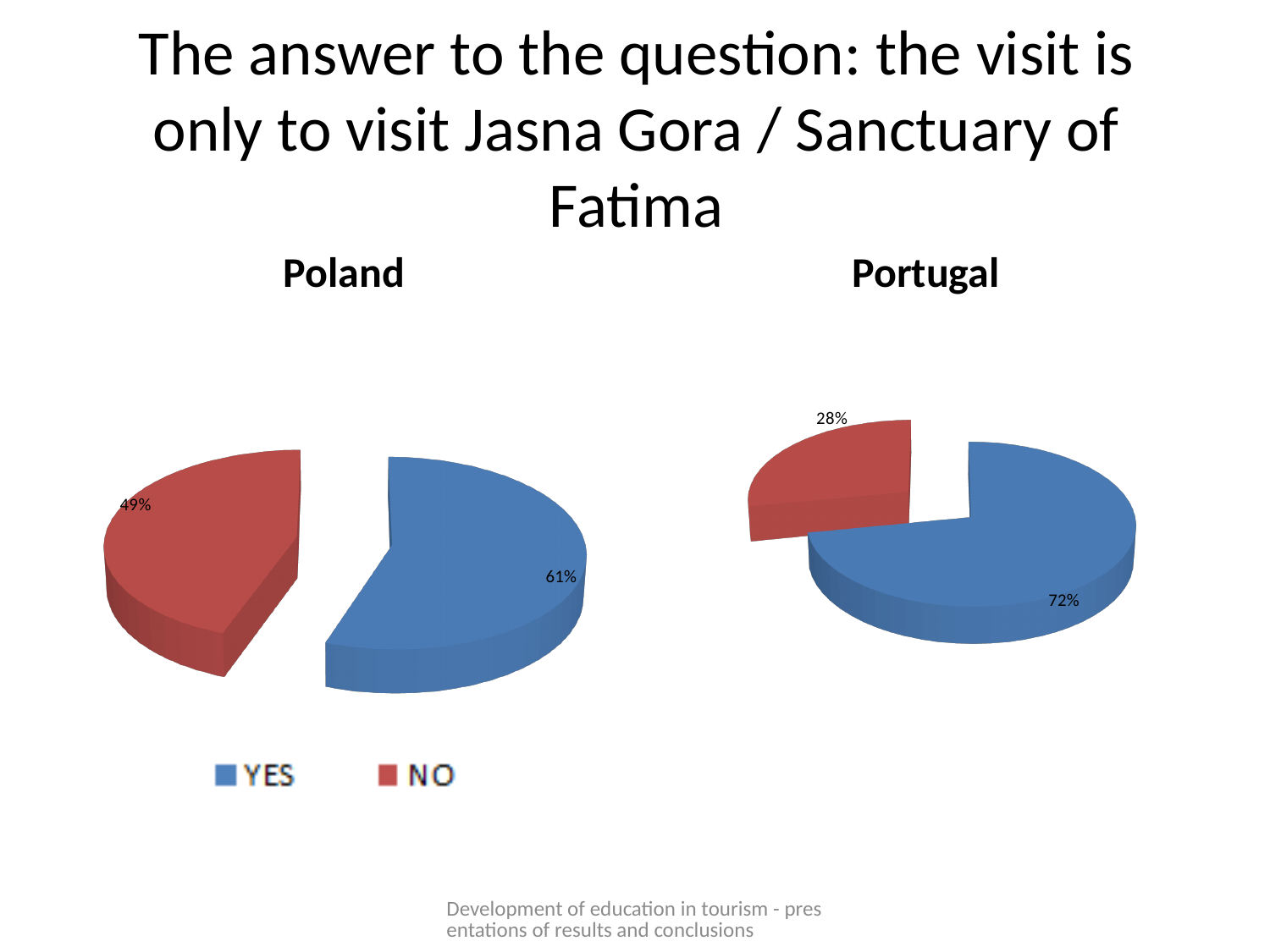
Which colour represents the NO answer in the charts? Red Which country has the higher YES percentage, Poland or Portugal? Portugal In the Poland chart, what percentage answered YES? 61% In the Portugal chart, what is the difference between the YES and NO percentages? 44% What kind of charts are shown on the slide? Pie charts In the Portugal chart, which answer has the largest slice? YES In the Portugal chart, what percentage answered YES? 72% In the Portugal chart, which answer has the smallest slice? NO In the Poland chart, what percentage answered NO? 49% How many entries does the legend list? 2 In the Poland chart, which answer has the larger slice? YES In the Portugal chart, what percentage answered NO? 28%